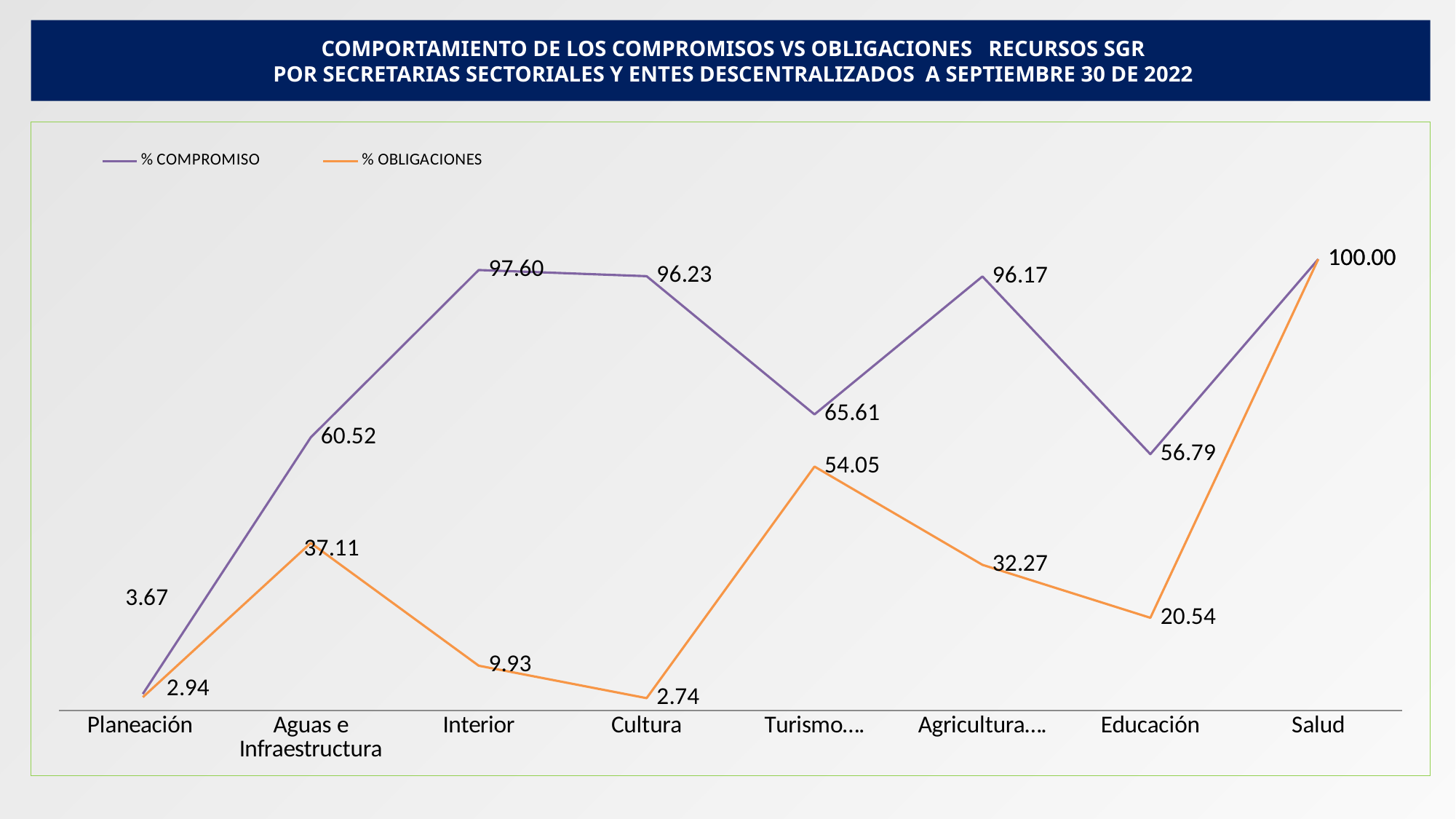
What type of chart is shown on the slide? line chart Which category has the lowest % COMPROMISO value? Planeación What is the difference between the % COMPROMISO and % OBLIGACIONES values for Cultura? 93.49 What is the % OBLIGACIONES value for Aguas e Infraestructura? 37.11 How many categories are shown on the x axis? 8 Which colour is used for the % OBLIGACIONES line? orange Which is larger for Educación: % COMPROMISO or % OBLIGACIONES? % COMPROMISO Which category has the highest % COMPROMISO value? Salud Which category has the lowest % OBLIGACIONES value? Cultura How many series does the legend list? 2 What is the % OBLIGACIONES value for Educación? 20.54 What is the % COMPROMISO value for Interior? 97.60